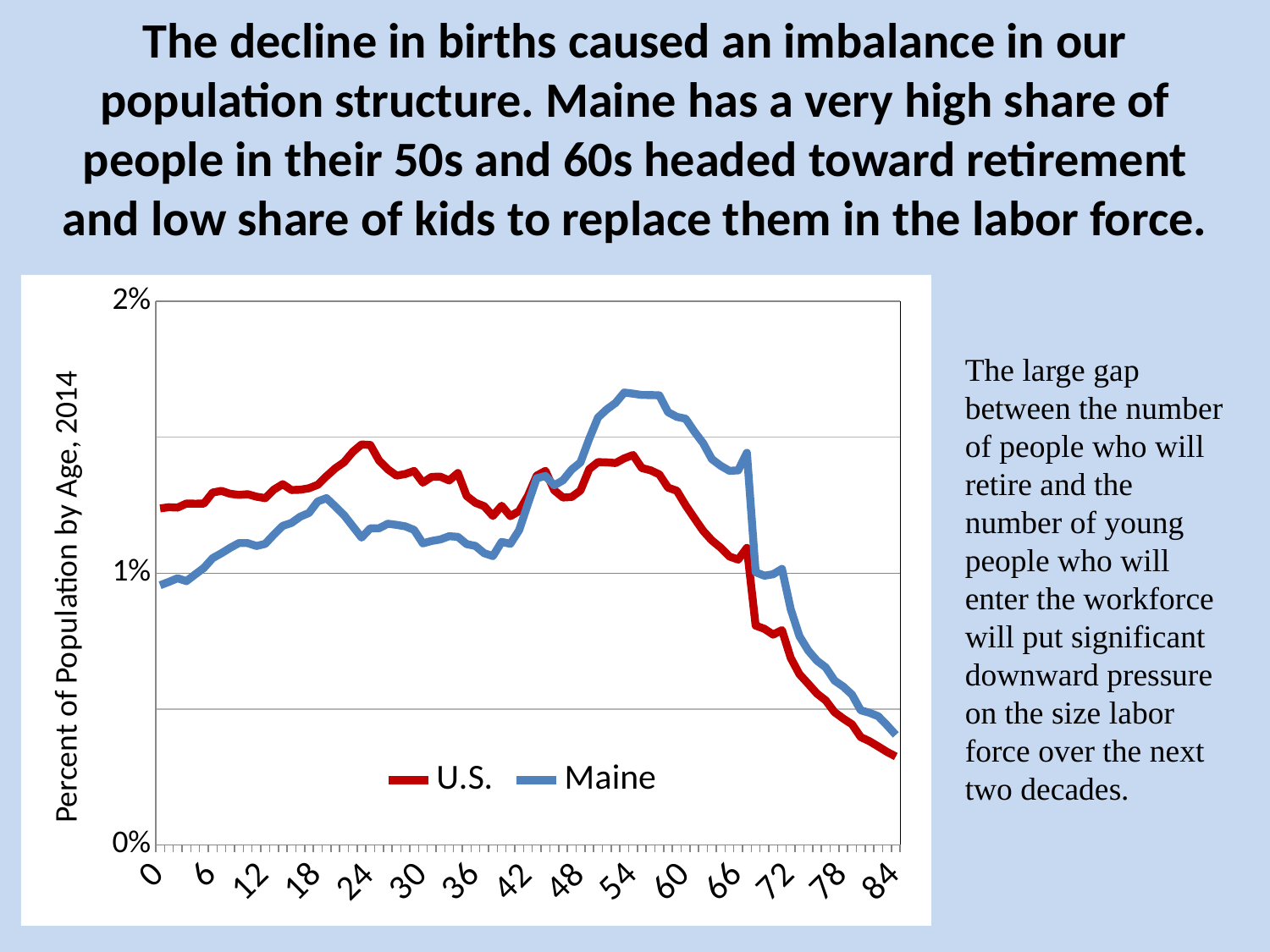
How many series does the chart's legend list? 2 Is the value for Maine at age 54 greater or less than 1%? greater At age 54, which series has the higher value, U.S. or Maine? Maine At age 24, which series has the higher value, U.S. or Maine? U.S. What kind of chart is shown on the slide? line chart What is the title of the chart's vertical axis? Percent of Population by Age, 2014 What are the two series named in the chart's legend? U.S. and Maine Do the values for Maine rise or fall between age 66 and age 84? fall Is the value for Maine at age 54 greater or less than 2%? less Which series reaches the higher peak value on the chart? Maine Is the value for Maine at age 0 greater or less than 1%? less